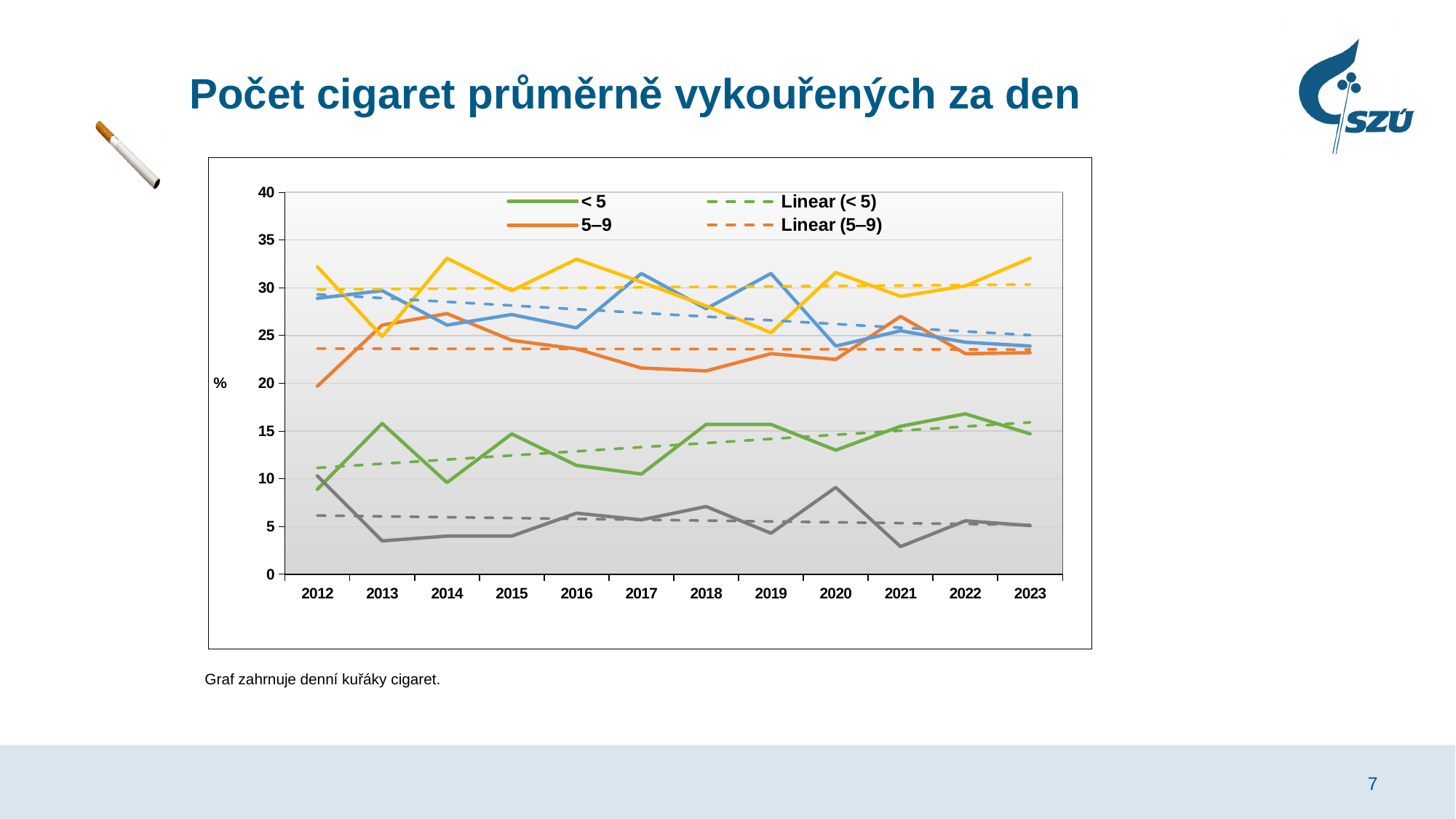
Is the value for the '5–9' series in 2021 greater or less than 25? greater What is the title of the chart? Počet cigaret průměrně vykouřených za den Does the 'Linear (< 5)' trend line rise or fall from 2012 to 2023? rise Is the value for the '< 5' series in 2012 greater or less than 10? less Is the value for the '< 5' series in 2022 greater or less than 15? greater In 2023, which series has the higher value, '< 5' or '5–9'? 5–9 How many years are shown on the x axis? 12 In which year is the '5–9' series at its lowest? 2012 What kind of chart is shown on the slide? line chart How many series does the chart legend list? 4